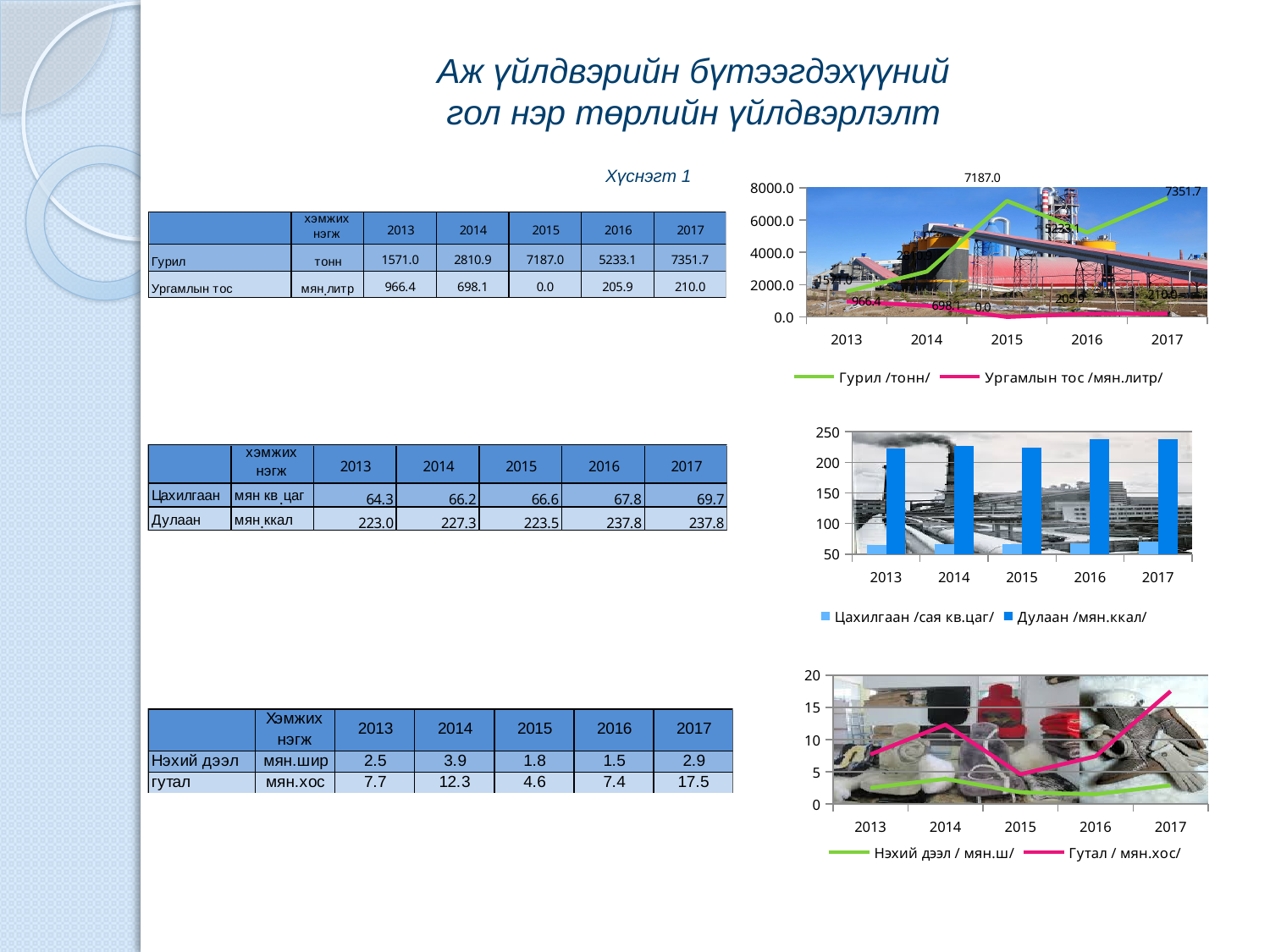
What kind of chart is the middle chart on the right (Цахилгаан / Дулаан)? Bar chart How many series does the legend of the top chart (Гурил / Ургамлын тос) list? 2 What kind of chart is the top chart on the right (Гурил / Ургамлын тос)? Line chart How many years are shown on the x axis of the middle chart (Цахилгаан / Дулаан)? 5 In the top chart (Гурил / Ургамлын тос), which year has the highest value for Гурил /тонн/? 2017 In the bottom chart (Нэхий дээл / Гутал), which series has the higher value in 2014? Гутал / мян.хос/ In the top chart (Гурил / Ургамлын тос), what is the value for Ургамлын тос /мян.литр/ in 2013? 966.4 In the top chart (Гурил / Ургамлын тос), which year has the lowest value for Ургамлын тос /мян.литр/? 2015 In the top chart (Гурил / Ургамлын тос), what is the value for Гурил /тонн/ in 2015? 7187.0 In the middle chart (Цахилгаан / Дулаан), is the value for Дулаан /мян.ккал/ in 2016 greater or less than 200? greater In the top chart (Гурил / Ургамлын тос), what is the difference between the Ургамлын тос values for 2017 and 2016? 4.1 In the middle chart (Цахилгаан / Дулаан), is the value for Цахилгаан /сая кв.цаг/ in 2013 greater or less than 100? less